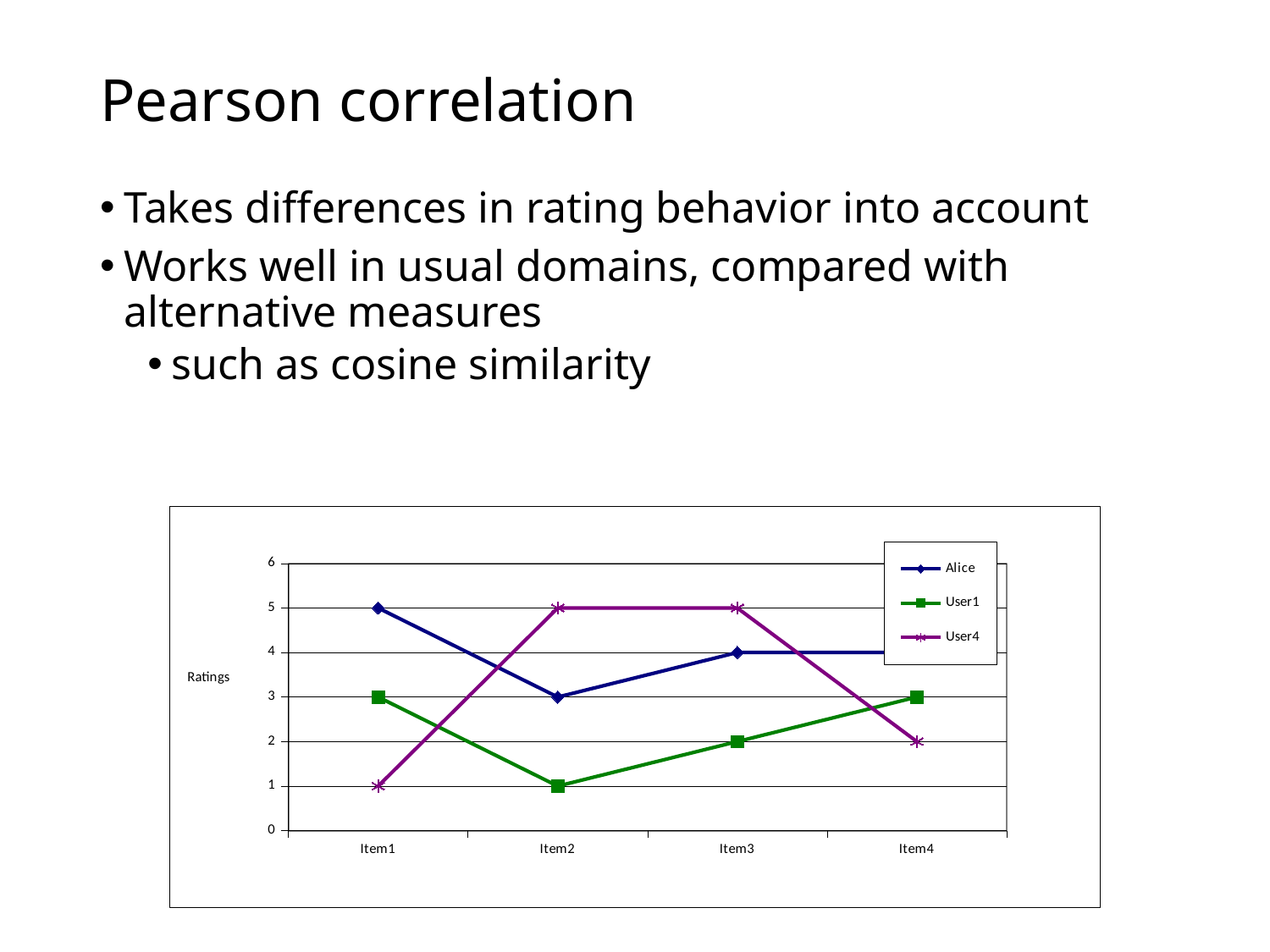
What is the label on the y axis? Ratings Which is larger for Item3: User4's rating or Alice's rating? User4 What is User1's rating for Item2? 1 What is User4's rating for Item4? 2 For which item is Alice's rating highest? Item1 For which item is User4's rating lowest? Item1 How many items are shown on the x axis? 4 What kind of chart is shown on the slide? line chart What is the difference between Alice's and User1's ratings for Item2? 2 Does User1's rating rise or fall from Item2 to Item4? rise What is Alice's rating for Item1? 5 How many series does the legend list? 3